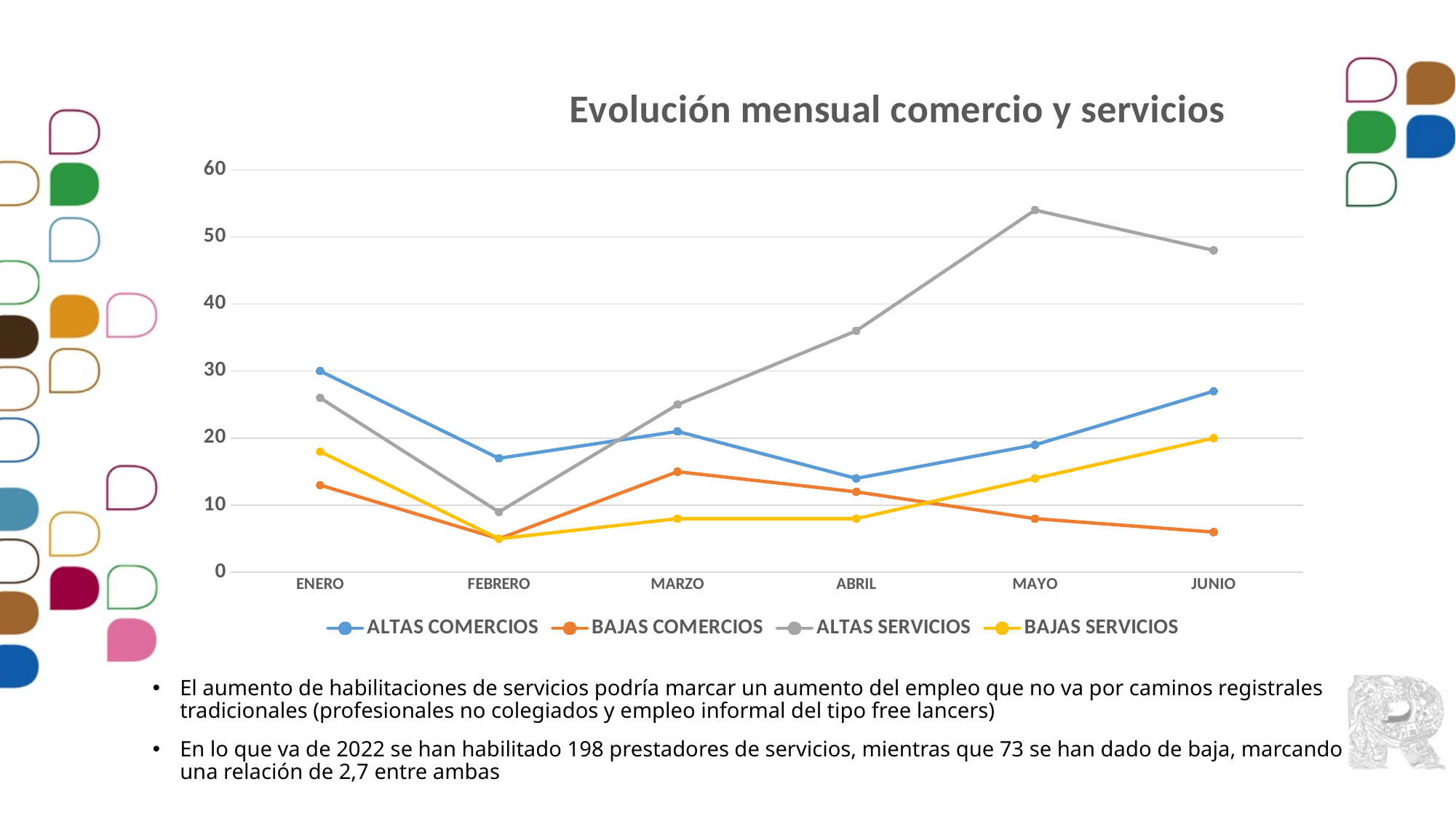
How many series does the legend list? 4 Is the value for ALTAS COMERCIOS in JUNIO greater or less than 20? greater Which series has the highest value in MAYO? ALTAS SERVICIOS Is the value for ALTAS SERVICIOS in MAYO greater or less than 50? greater In ABRIL, which is larger: ALTAS SERVICIOS or ALTAS COMERCIOS? ALTAS SERVICIOS How many months are shown on the x axis? 6 Is the value for BAJAS COMERCIOS in JUNIO greater or less than 10? less What is the title of the chart? Evolución mensual comercio y servicios What kind of chart is shown on the slide? Line chart Does the ALTAS SERVICIOS line rise or fall from FEBRERO to MAYO? Rise In which month does ALTAS SERVICIOS reach its lowest value? FEBRERO In which month does ALTAS SERVICIOS reach its highest value? MAYO